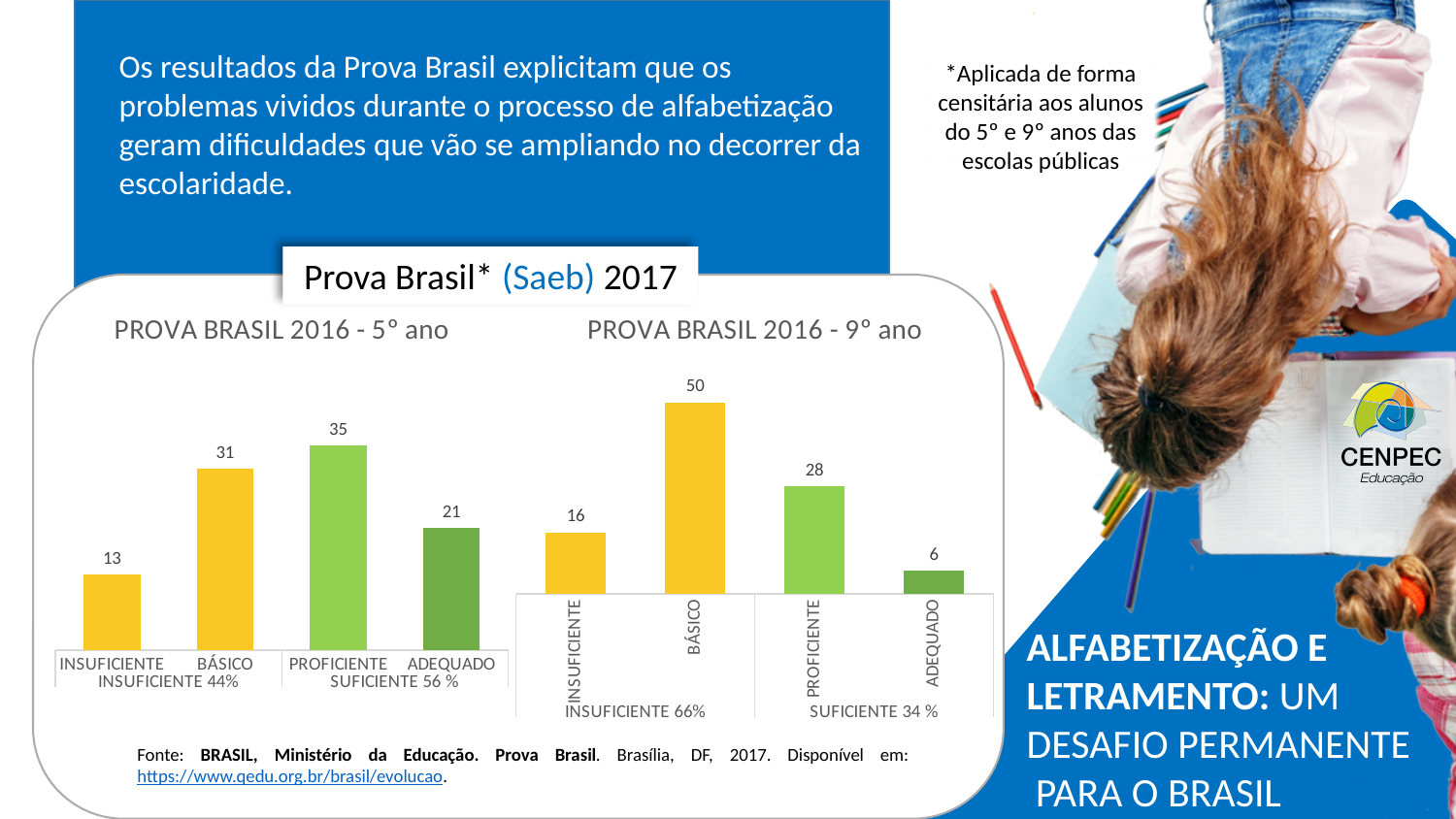
Which is larger: INSUFICIENTE in the 5° ano chart or INSUFICIENTE in the 9° ano chart? 9° ano In the chart 'PROVA BRASIL 2016 - 5° ano', what is the value for BÁSICO? 31 What percentage is labelled as SUFICIENTE below the chart 'PROVA BRASIL 2016 - 9° ano'? 34 % How many categories are shown in the chart 'PROVA BRASIL 2016 - 5° ano'? 4 In the chart 'PROVA BRASIL 2016 - 9° ano', what is the value for ADEQUADO? 6 In the chart 'PROVA BRASIL 2016 - 9° ano', what is the difference between BÁSICO and PROFICIENTE? 22 What type of chart is 'PROVA BRASIL 2016 - 9° ano'? Bar chart In the chart 'PROVA BRASIL 2016 - 5° ano', which category has the highest value? PROFICIENTE In the chart 'PROVA BRASIL 2016 - 5° ano', what is the difference between ADEQUADO and INSUFICIENTE? 8 In the chart 'PROVA BRASIL 2016 - 5° ano', what is the combined value of PROFICIENTE and ADEQUADO? 56 In the chart 'PROVA BRASIL 2016 - 9° ano', which category has the lowest value? ADEQUADO In the chart 'PROVA BRASIL 2016 - 9° ano', is BÁSICO or PROFICIENTE larger? BÁSICO